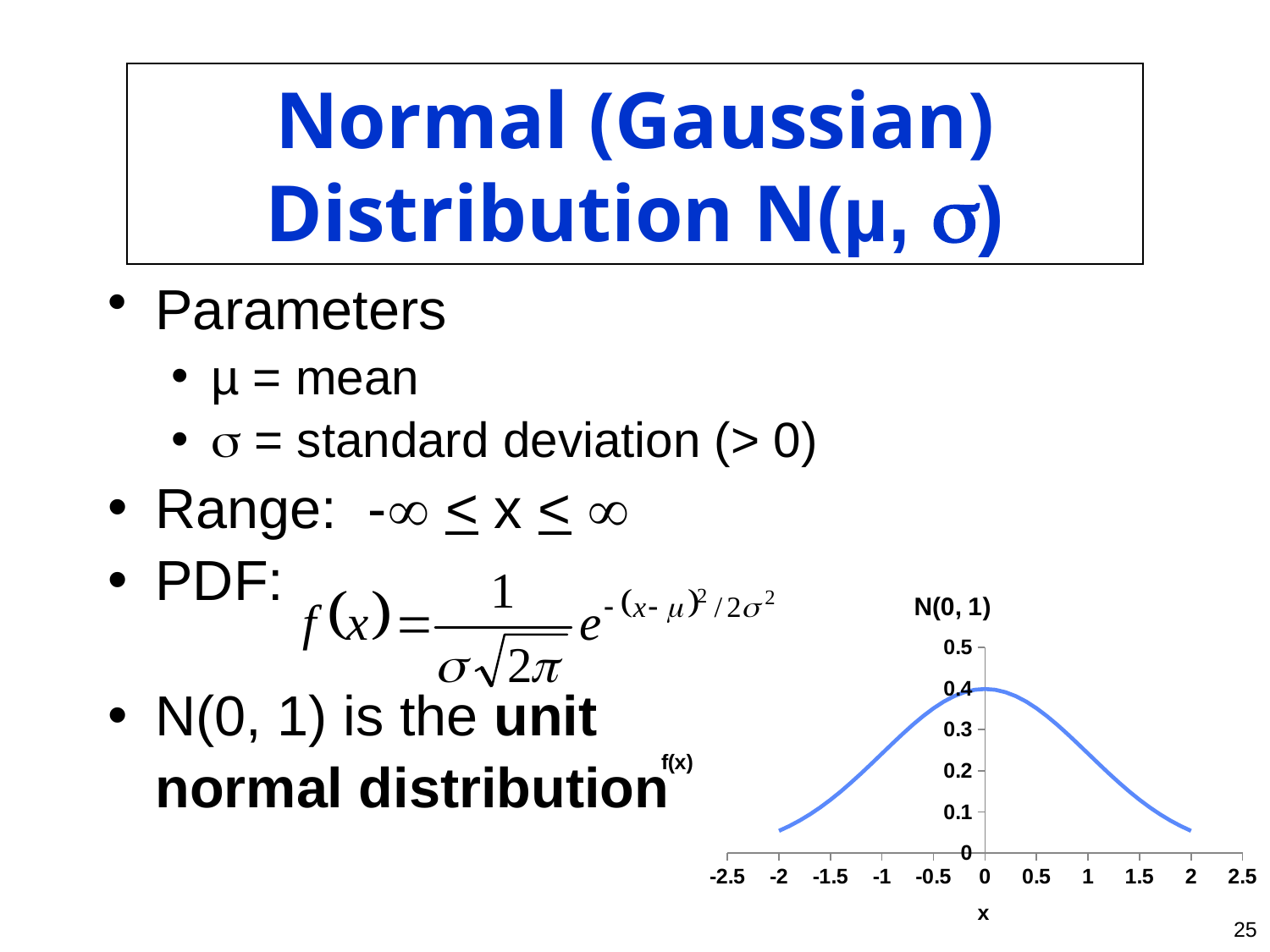
What is the title of the chart? N(0, 1) Which is larger, the value of the curve at x = -0.5 or at x = 1.5? x = -0.5 Is the value of the curve at x = -1 greater or less than 0.2? greater What kind of chart is shown on the slide? line chart At which value of x does the curve reach its highest point? 0 Is the value of the curve at x = 0 greater or less than 0.3? greater Is the value of the curve at x = 2 greater or less than 0.1? less Does the curve rise or fall as x goes from 0 to 2? fall How many lines are plotted on the chart? 1 What label is on the vertical axis of the chart? f(x) Does the curve rise or fall as x goes from -2 to 0? rise